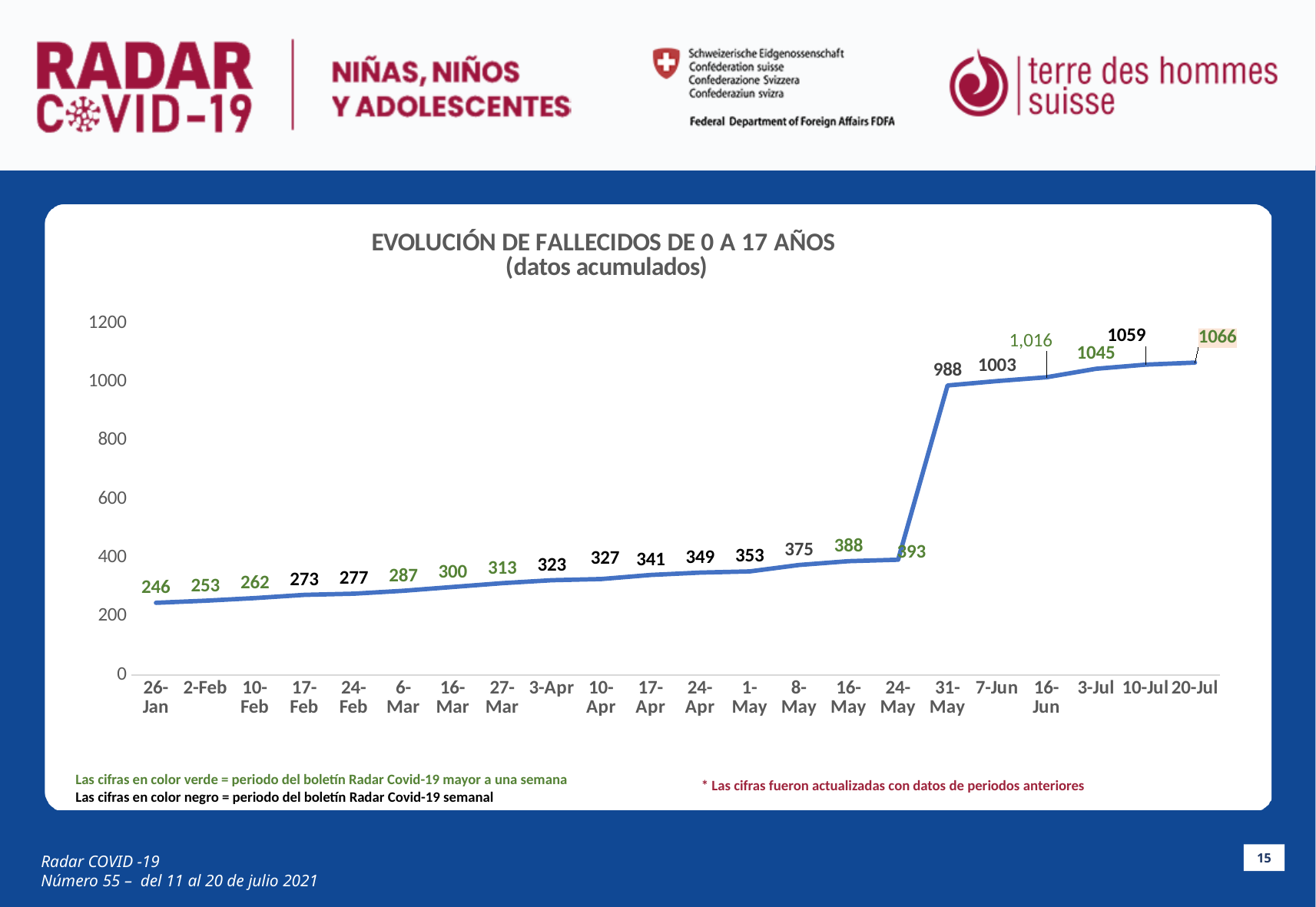
Do the values rise or fall from left to right along the x axis? Rise What is the cumulative value shown for 31-May? 988 By how much does the value increase from 24-May to 31-May? 595 What is the value labelled for 16-Jun? 1,016 How many dates are plotted along the x axis? 22 Which date has the highest value on the chart? 20-Jul Which is larger, the value for 8-May or the value for 16-May? 16-May Which date has the lowest value on the chart? 26-Jan What is the value shown for 20-Jul? 1066 What is the cumulative value shown for 26-Jan? 246 What is the difference between the values for 10-Jul and 20-Jul? 7 What kind of chart is shown on the slide? Line chart